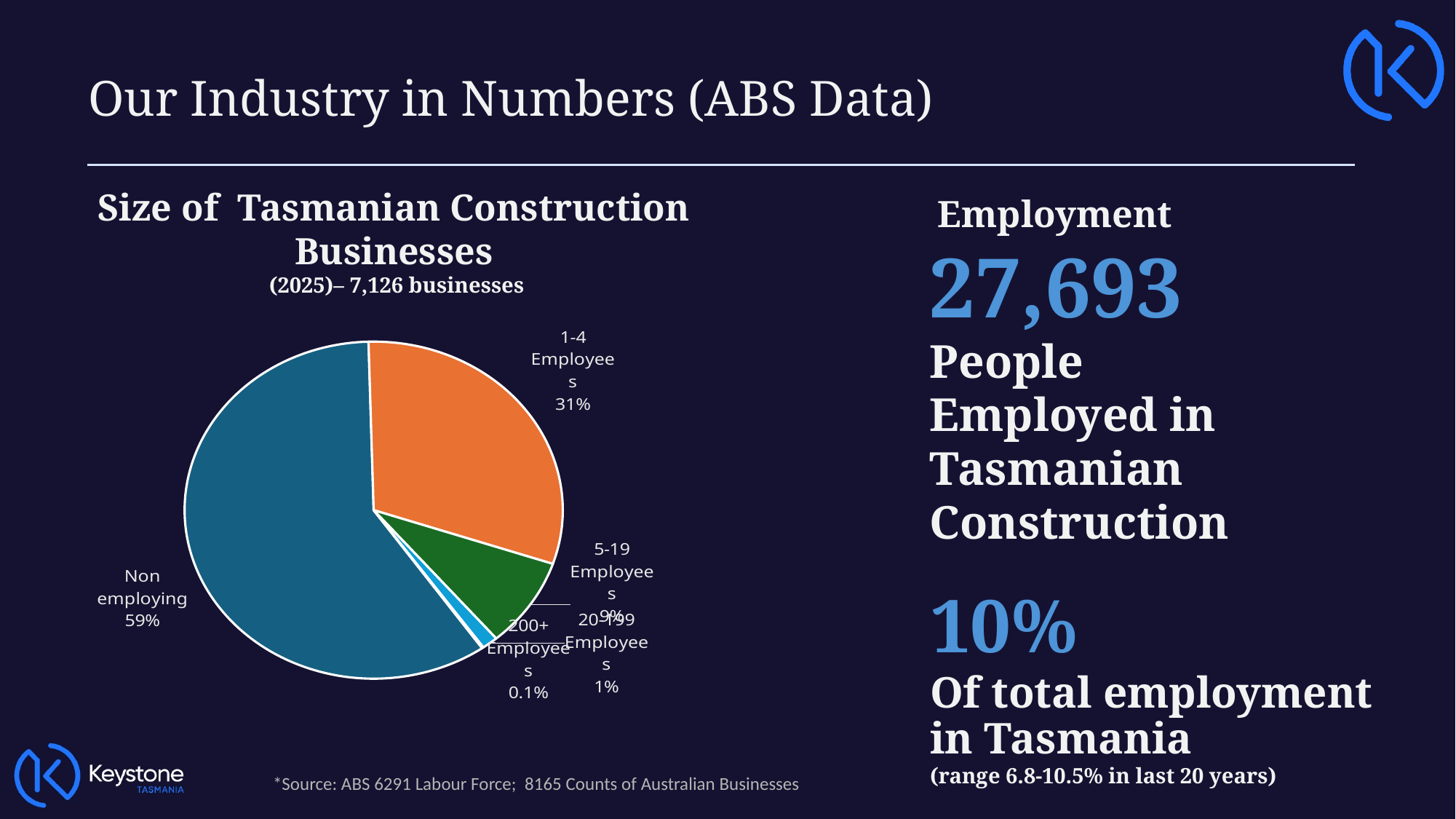
Which business size category has the smallest slice of the pie chart? 200+ Employees Which business size category has the largest slice of the pie chart? Non employing What share of Tasmanian construction businesses have 20-199 employees? 1% What is the title of the pie chart? Size of Tasmanian Construction Businesses Which slice is larger: 1-4 Employees or 5-19 Employees? 1-4 Employees What share of Tasmanian construction businesses have 200+ employees? 0.1% What share of Tasmanian construction businesses have 1-4 employees? 31% What is the difference in percentage points between the Non employing slice and the 1-4 Employees slice? 28 How many slices does the pie chart have? 5 What kind of chart is shown on the slide? pie chart How many businesses does the pie chart subtitle say the 2025 data covers? 7,126